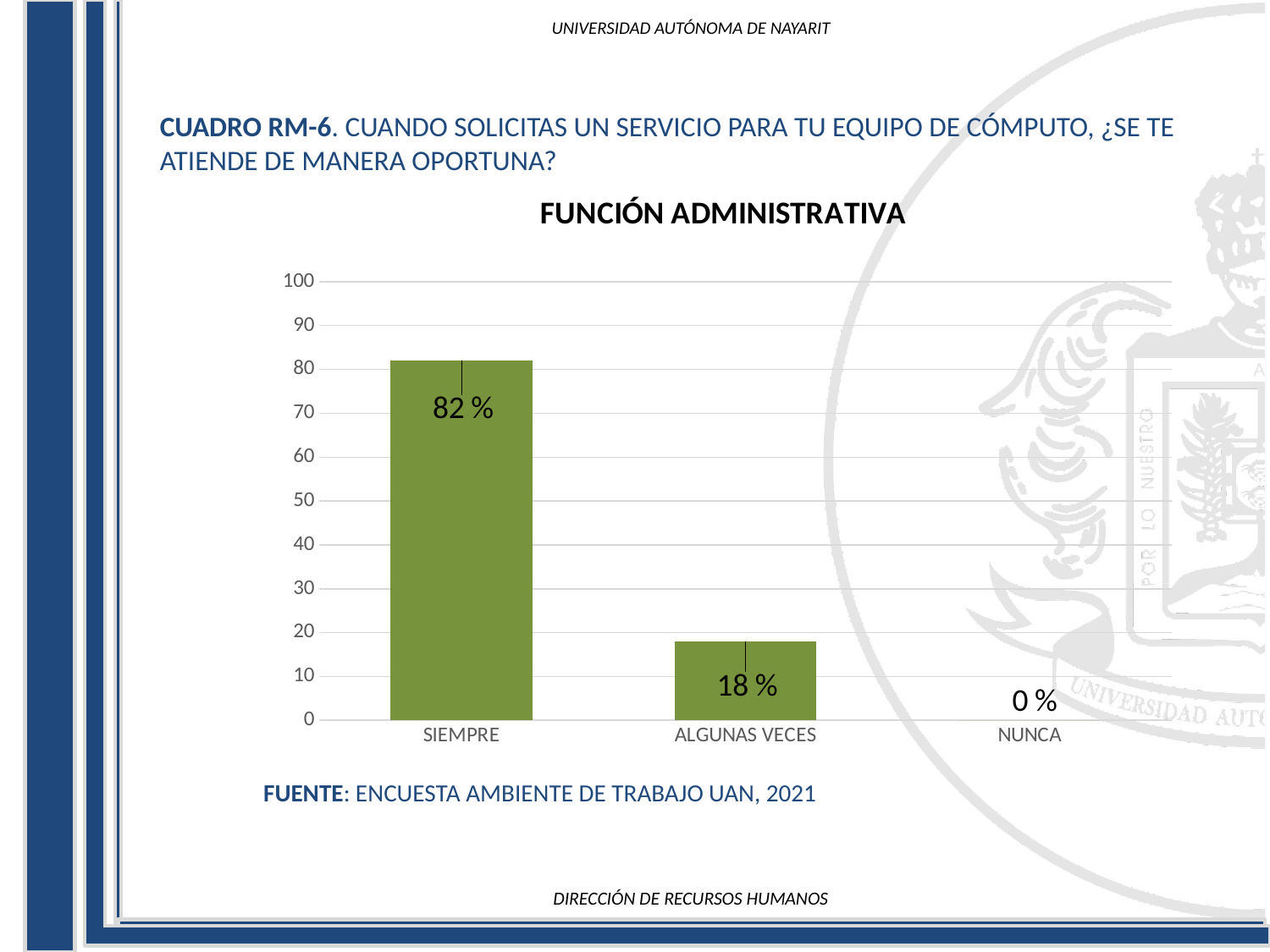
Is the value for SIEMPRE greater or less than 50? greater Which category has the lowest value? NUNCA What is the difference between the values for SIEMPRE and ALGUNAS VECES? 64 % What kind of chart is shown on the slide? bar chart Which category has the highest value? SIEMPRE What is the title of the chart? FUNCIÓN ADMINISTRATIVA What is the value for ALGUNAS VECES? 18 % What is the value for NUNCA? 0 % Which is larger, the value for ALGUNAS VECES or the value for NUNCA? ALGUNAS VECES Is the value for ALGUNAS VECES greater or less than 30? less How many categories are shown on the x axis? 3 What is the value for SIEMPRE? 82 %